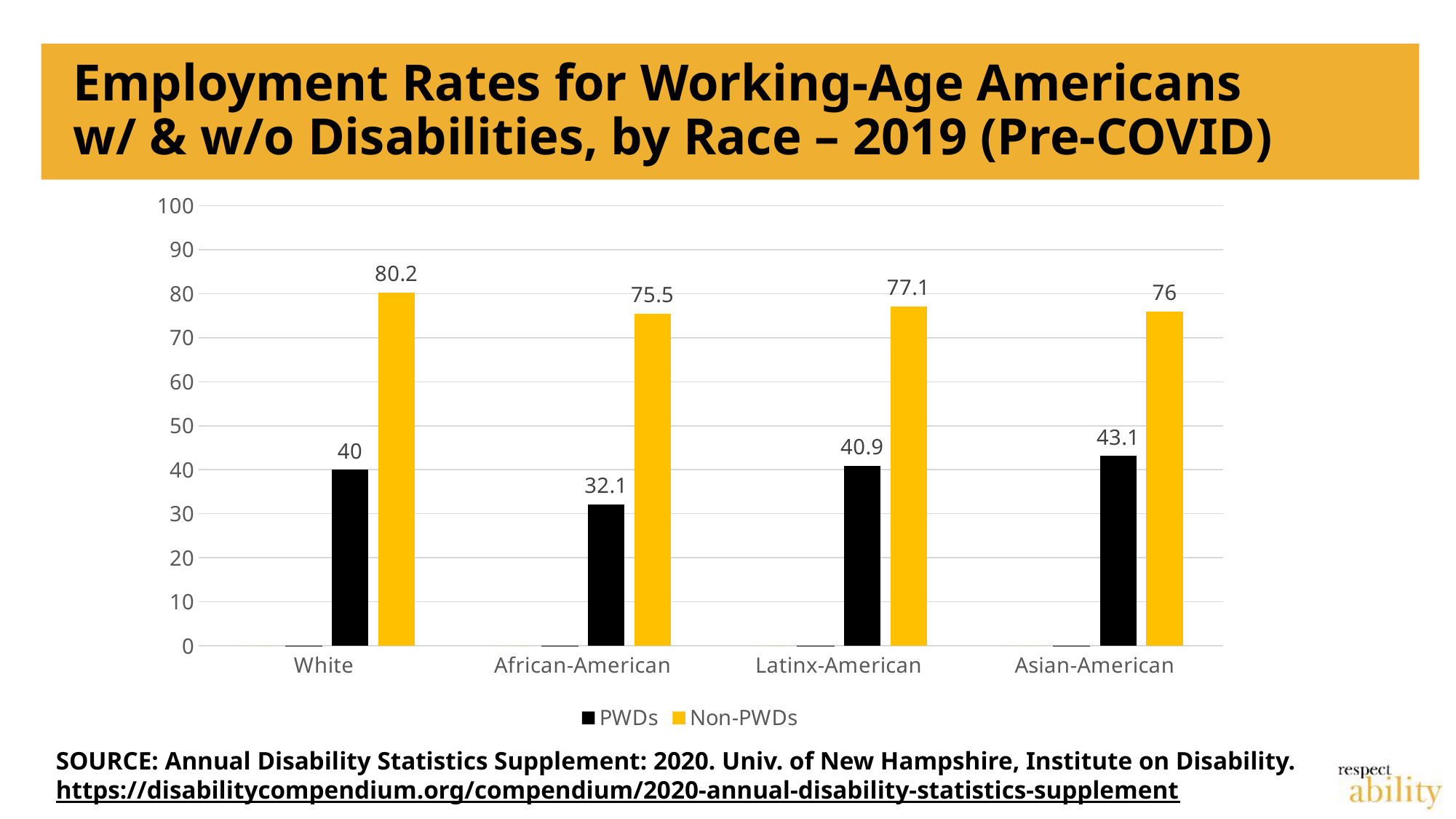
What is the employment rate for Non-PWDs in the African-American category? 75.5 What is the employment rate for Non-PWDs in the Asian-American category? 76 Which race category has the lowest PWDs employment rate? African-American What is the difference between the Non-PWDs and PWDs employment rates for the White category? 40.2 How many race categories are shown on the x axis? 4 Which race category has the highest Non-PWDs employment rate? White What is the employment rate for PWDs in the White category? 40 How many series does the legend list? 2 What is the employment rate for PWDs in the Latinx-American category? 40.9 What colour are the Non-PWDs bars? Yellow What kind of chart is shown on the slide? Bar chart Which is larger, the PWDs employment rate for Asian-American or for Latinx-American? Asian-American